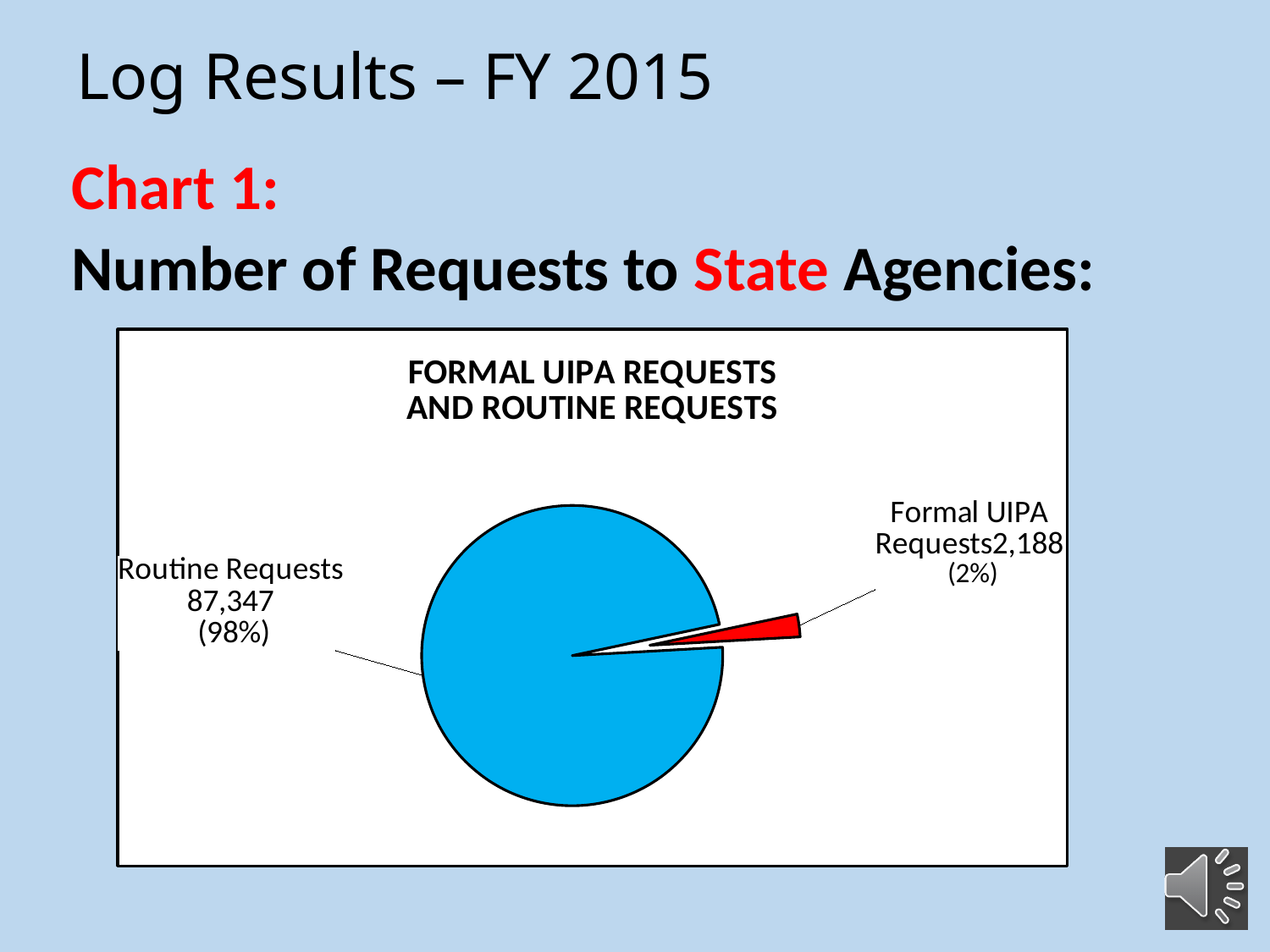
Which category has the smallest slice of the pie? Formal UIPA Requests What is the total number of requests shown in the pie chart? 89,535 What is the difference between the number of Routine Requests and Formal UIPA Requests? 85,159 What is the title of the pie chart? FORMAL UIPA REQUESTS AND ROUTINE REQUESTS Which is larger, Routine Requests or Formal UIPA Requests? Routine Requests What share of the pie do Routine Requests represent? 98% What is the value for Routine Requests? 87,347 How many categories are shown in the pie chart? 2 What type of chart is shown on the slide? pie chart What share of the pie do Formal UIPA Requests represent? 2% What is the value for Formal UIPA Requests? 2,188 Which category has the largest slice of the pie? Routine Requests